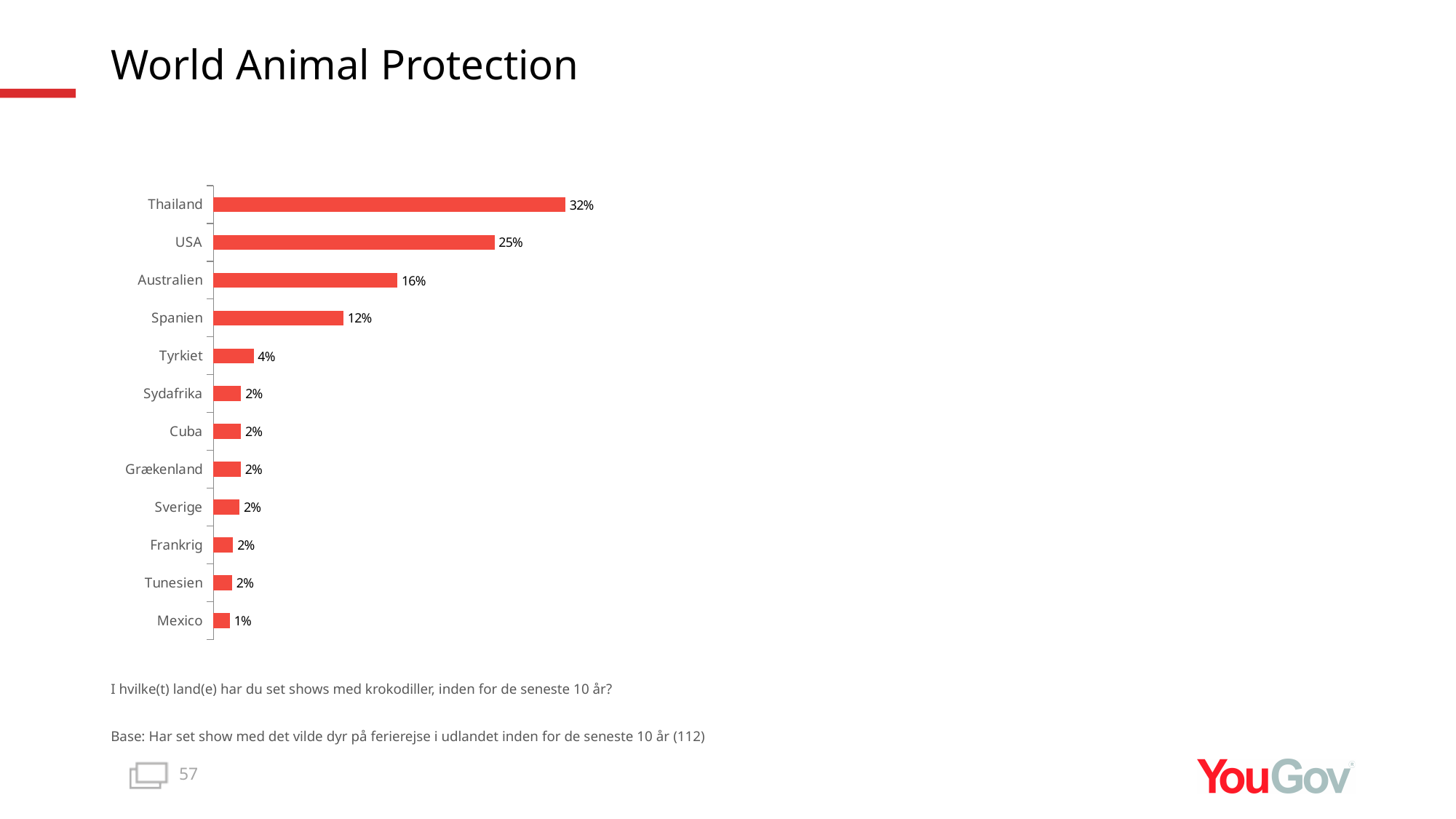
Which country has the lowest value? Mexico How many countries are shown in the chart? 12 Which is larger, the value for USA or the value for Spanien? USA Which country has the highest value? Thailand Do the values rise or fall going from the top bar to the bottom bar? Fall What is the value for Australien? 16% What kind of chart is shown on the slide? Bar chart What is the difference between the values for Thailand and USA? 7% What is the value for Thailand? 32% What colour are the bars in the chart? Red What is the value for Tyrkiet? 4% What is the difference between the values for Australien and Spanien? 4%